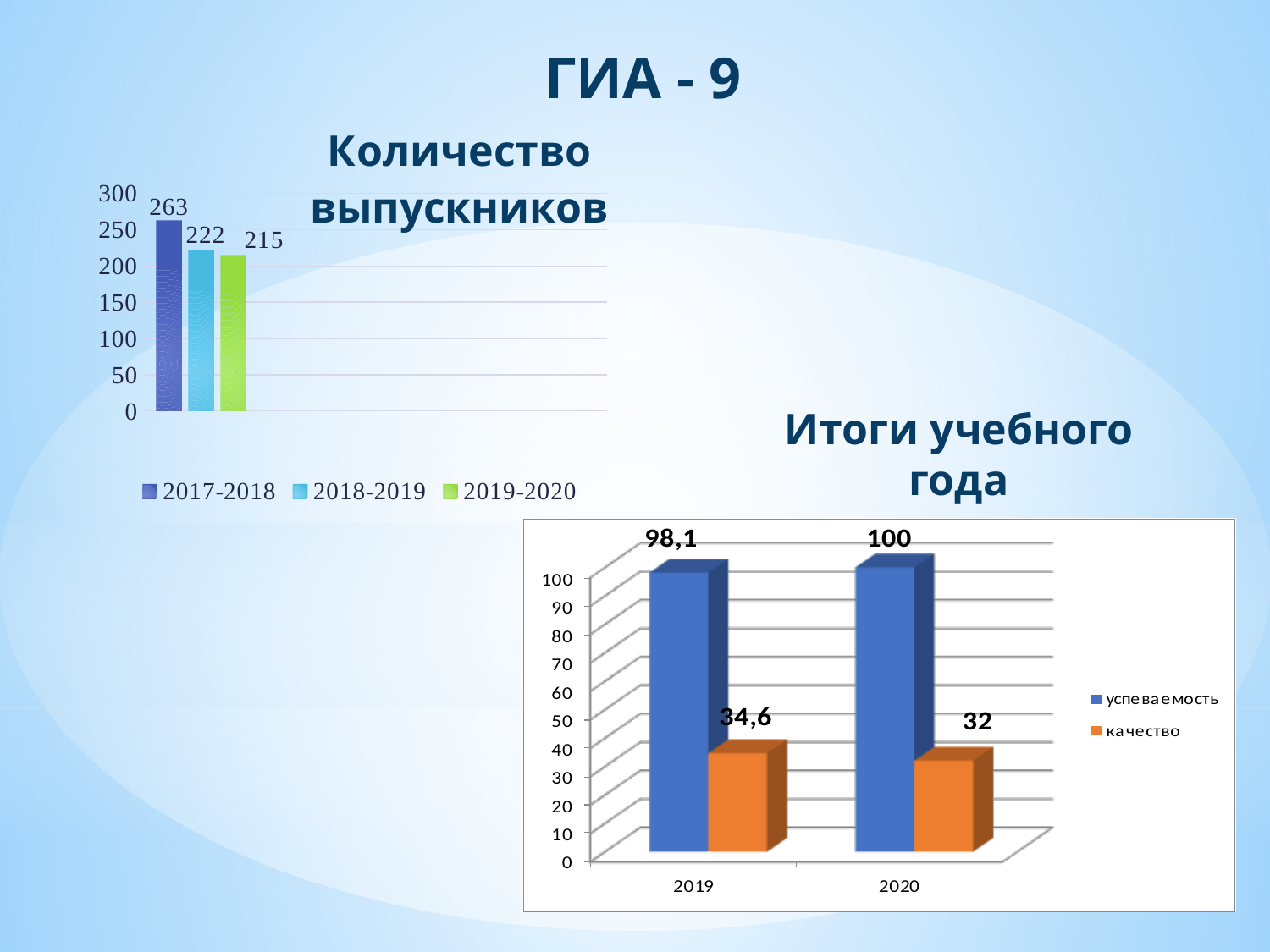
In the chart 'Итоги учебного года', what is the difference between успеваемость and качество for 2020? 68 In the chart 'Количество выпускников', do the values rise or fall from 2017-2018 to 2019-2020? fall In the chart 'Количество выпускников', what is the value for 2017-2018? 263 In the chart 'Количество выпускников', how many series does the legend list? 3 In the chart 'Итоги учебного года', which year has the higher value of качество, 2019 or 2020? 2019 In the chart 'Итоги учебного года', how many categories are shown on the x axis? 2 What kind of chart is 'Итоги учебного года'? bar chart In the chart 'Итоги учебного года', what is the value of успеваемость for 2019? 98,1 In the chart 'Итоги учебного года', what is the value of качество for 2020? 32 In the chart 'Количество выпускников', what is the difference between the values for 2017-2018 and 2018-2019? 41 In the chart 'Количество выпускников', what is the value for 2019-2020? 215 In the chart 'Количество выпускников', which year has the highest value? 2017-2018